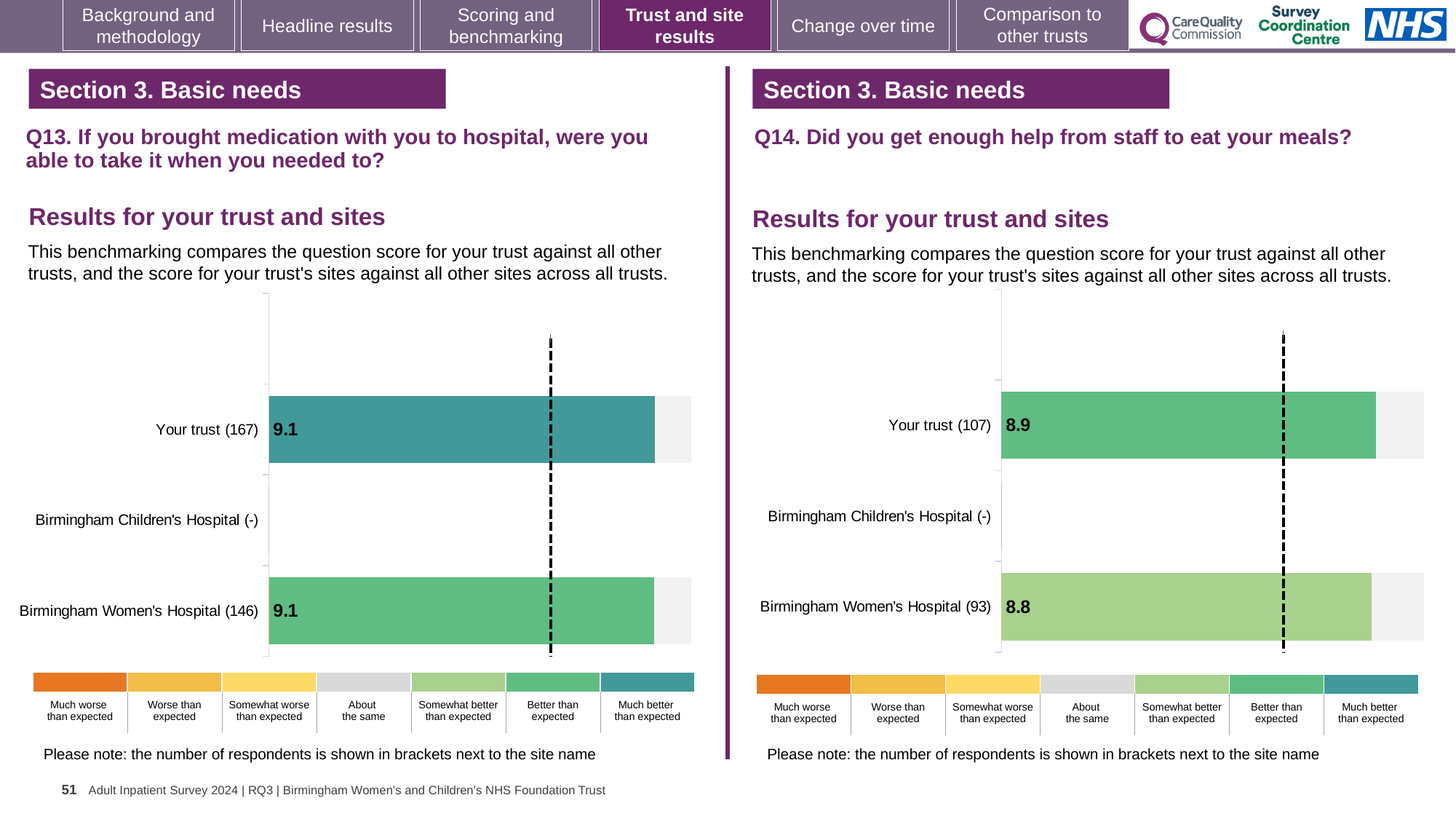
In the Q14 chart on the right, which has the higher score, Your trust or Birmingham Women's Hospital? Your trust In the Q14 chart on the right, what is the score for Birmingham Women's Hospital? 8.8 In the Q14 chart on the right, what is the score for Your trust? 8.9 What kind of chart is used for the Q14 results on the right? Bar chart In the Q13 chart on the left, how many site/trust categories are listed on the vertical axis? 3 In the Q13 chart on the left, what is the score for Birmingham Women's Hospital? 9.1 In the Q14 chart on the right, how many respondents are shown in brackets for Birmingham Women's Hospital? 93 In the Q14 chart on the right, what is the difference between the score for Your trust and the score for Birmingham Women's Hospital? 0.1 In the Q13 chart on the left, how many respondents are shown in brackets for Your trust? 167 In the Q14 chart on the right, which benchmarking category does the colour of the Birmingham Women's Hospital bar correspond to in the legend? Somewhat better than expected In the Q13 chart on the left, what is the score for Your trust? 9.1 In the Q13 chart on the left, which benchmarking category does the colour of the Your trust bar correspond to in the legend? Much better than expected